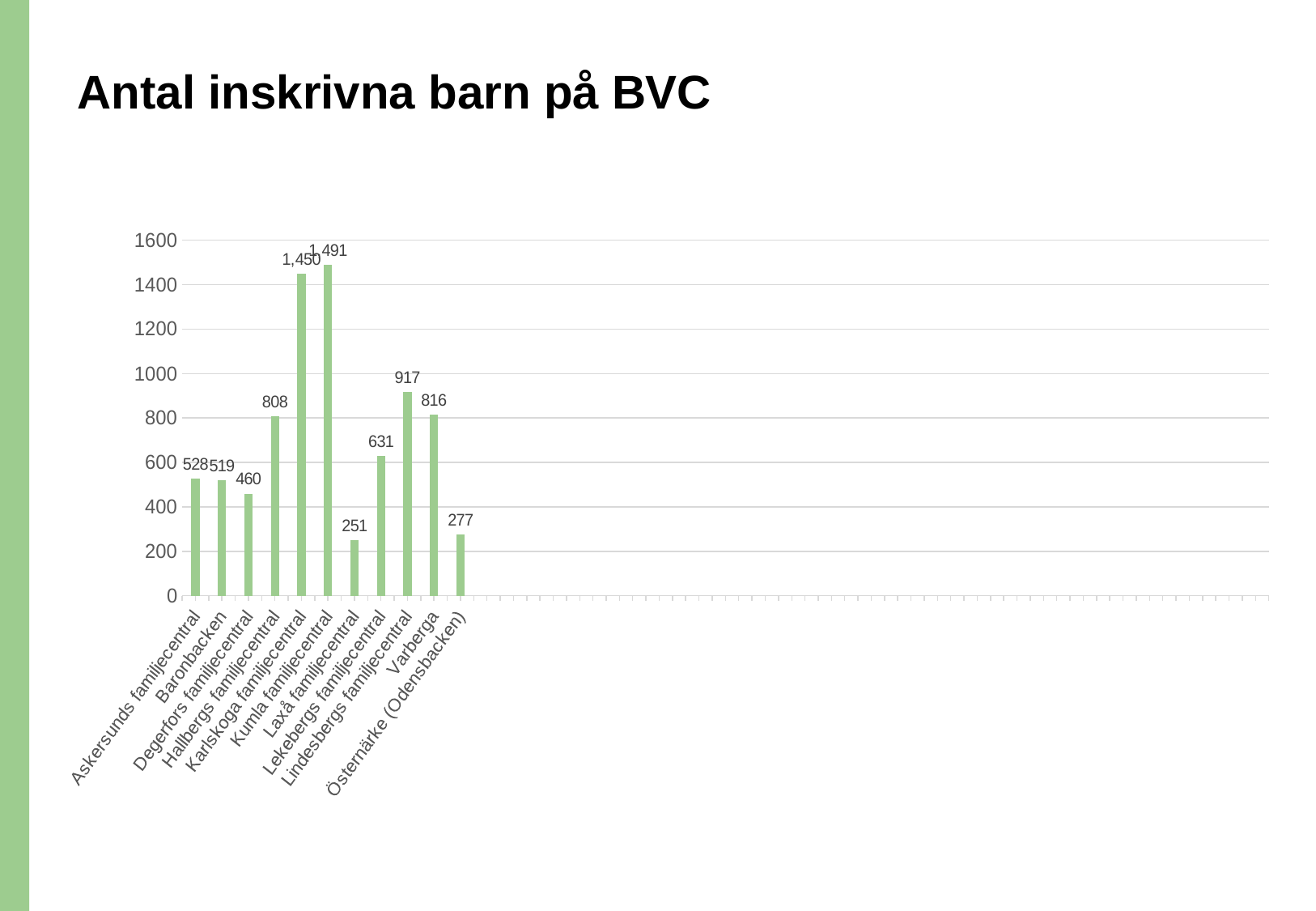
Which category has the highest value? Kumla familjecentral What is the value for Lindesbergs familjecentral? 917 What is the value for Baronbacken? 519 How many categories are shown in the chart? 11 What kind of chart is shown on the slide? bar chart Is the value for Degerfors familjecentral greater or less than 600? less Which is larger, the value for Hallbergs familjecentral or the value for Lekebergs familjecentral? Hallbergs familjecentral What is the value for Östernärke (Odensbacken)? 277 Which category has the lowest value? Laxå familjecentral What is the difference between the values for Lindesbergs familjecentral and Varberga? 101 What is the title of the slide? Antal inskrivna barn på BVC What is the value for Karlskoga familjecentral? 1,450